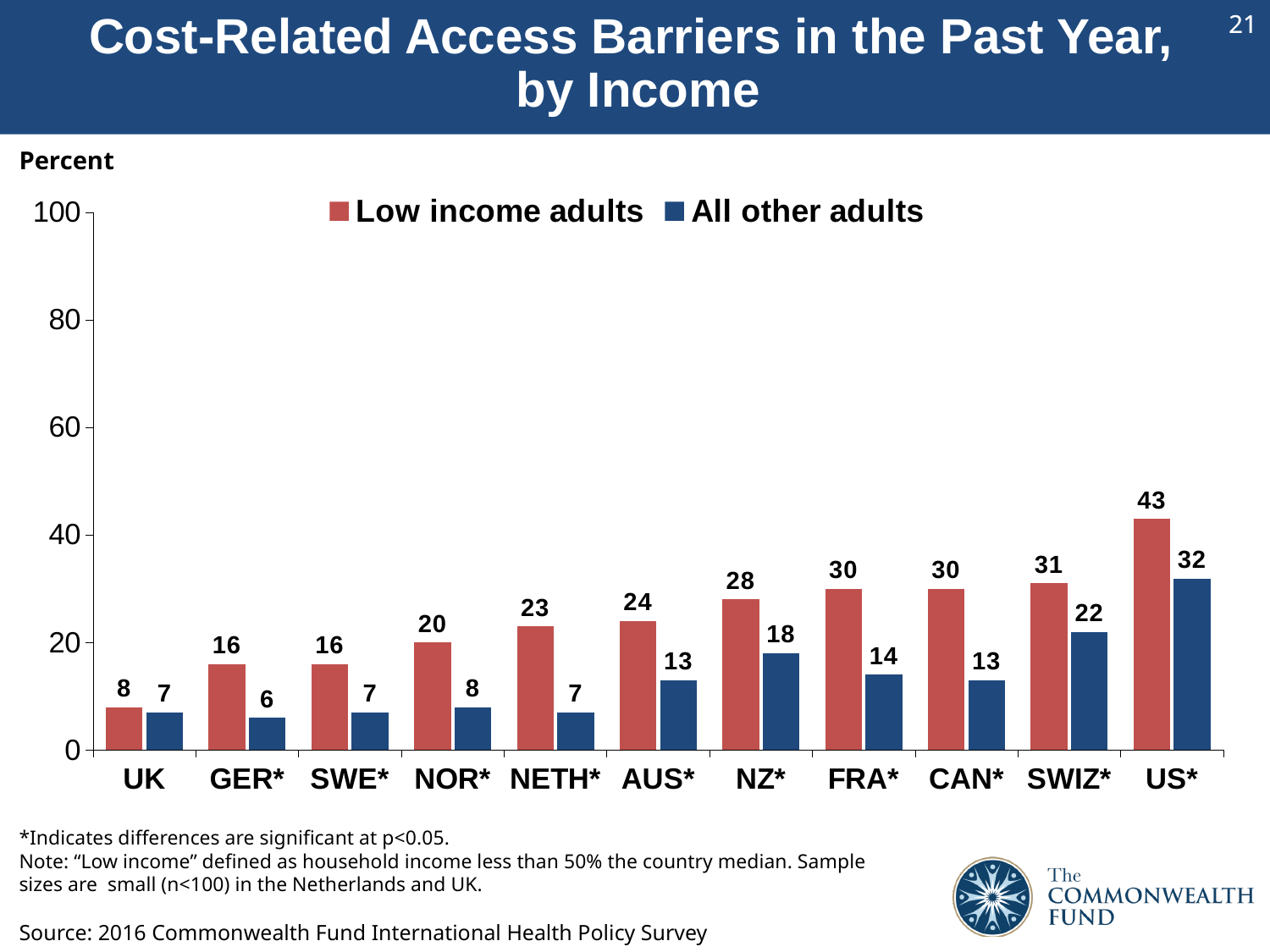
Which country has the lowest value for All other adults? GER* How many countries are shown on the x axis? 11 What is the difference between Low income adults and All other adults in SWIZ*? 9 What is the value for All other adults in NZ*? 18 What is the value for Low income adults in NOR*? 20 What is the value for Low income adults in the US*? 43 How many series does the legend list? 2 What kind of chart is shown on the slide? Bar chart Which is larger: the Low income adults value for FRA* or the Low income adults value for AUS*? FRA* Is the value for Low income adults in the US* greater or less than 40? greater Which country has the highest value for Low income adults? US* Which colour represents Low income adults in the chart? Red